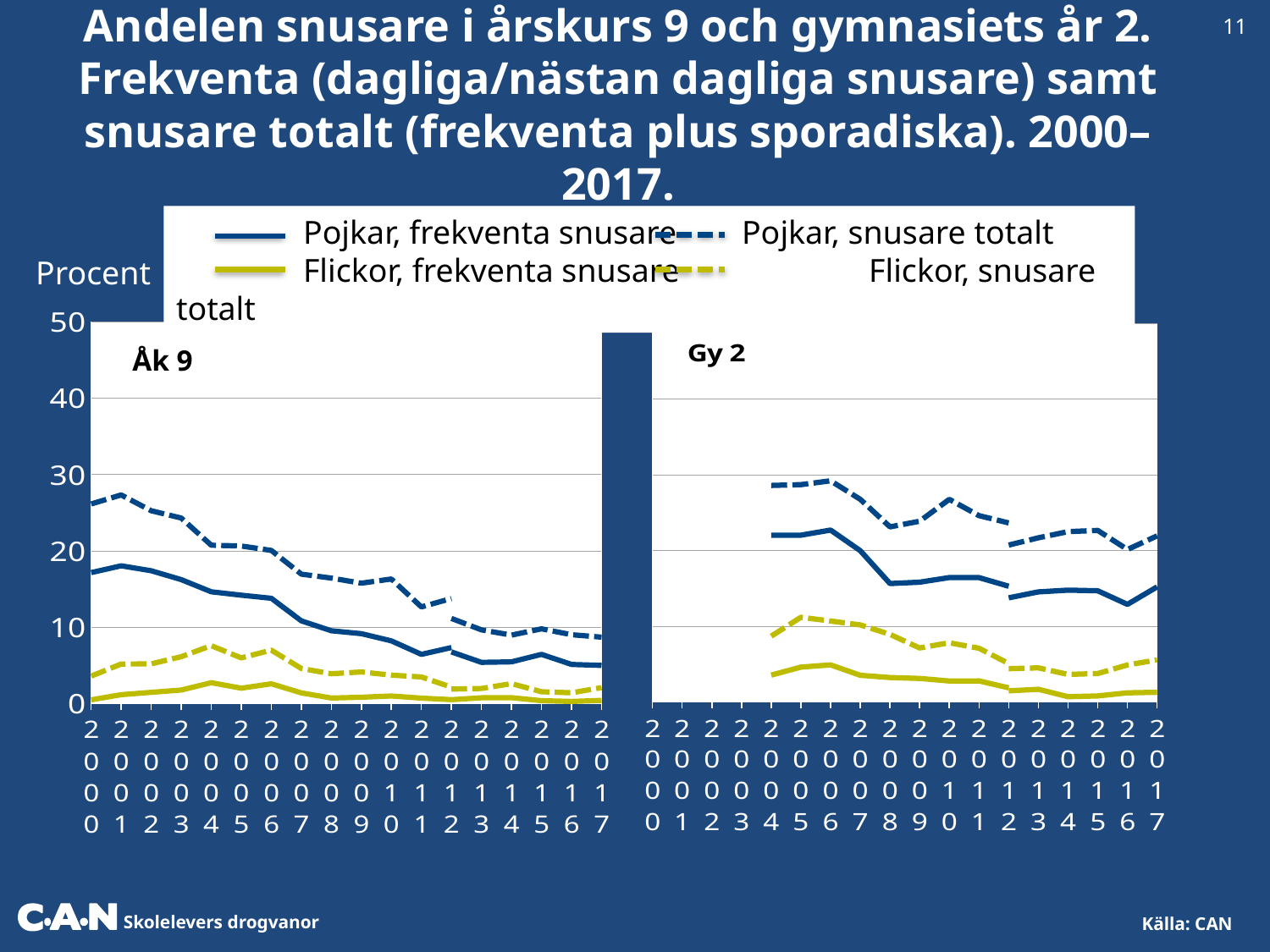
In the Gy 2 chart, is the value for Pojkar, snusare totalt in 2006 greater or less than 20? greater In the Åk 9 chart, does the Pojkar, frekventa snusare line rise or fall from 2000 to 2017? Fall What is the label on the y axis of the charts? Procent In the Åk 9 chart, which is larger in 2000: Pojkar, frekventa snusare or Flickor, frekventa snusare? Pojkar, frekventa snusare In the Åk 9 chart, how many years are shown on the x axis? 18 In the Gy 2 chart, which is larger in 2017: Pojkar, snusare totalt or Flickor, snusare totalt? Pojkar, snusare totalt How many series does the legend list? 4 In the Åk 9 chart, is the value for Pojkar, frekventa snusare in 2017 greater or less than 10? less In the Gy 2 chart, is the value for Flickor, frekventa snusare in 2017 greater or less than 10? less What kind of chart is shown on the slide? Line chart